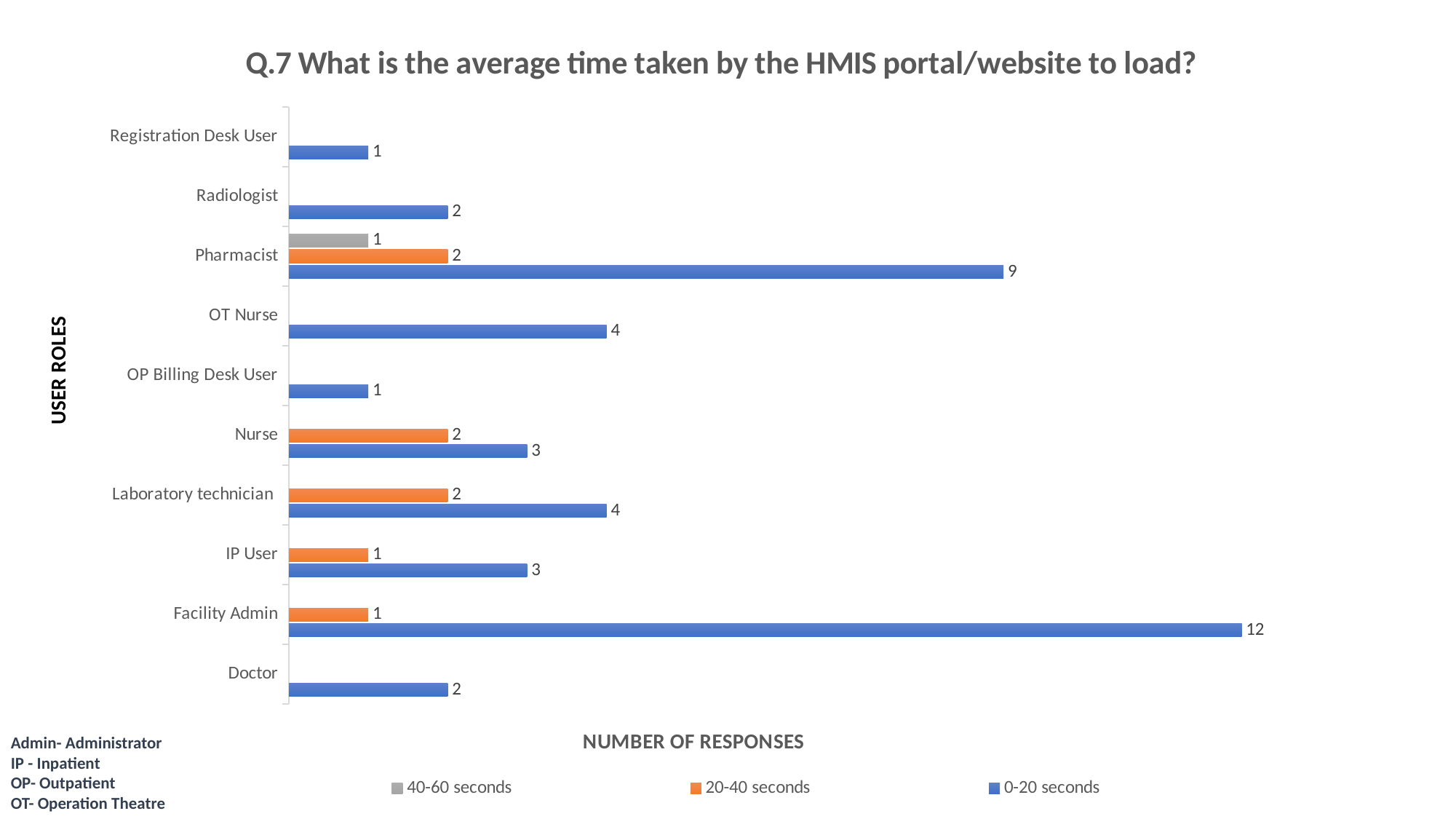
Which user role has the highest number of responses in the 0-20 seconds series? Facility Admin What is the total number of responses across all series for Pharmacist? 12 What is the difference between the 0-20 seconds responses for Facility Admin and Pharmacist? 3 What is the number of responses for Pharmacist in the 40-60 seconds series? 1 What is the number of responses for Nurse in the 20-40 seconds series? 2 What is the number of responses for Facility Admin in the 0-20 seconds series? 12 Which is larger: the 0-20 seconds value for OT Nurse or for Radiologist? OT Nurse What kind of chart is shown on the slide? bar chart What is the title of the chart? Q.7 What is the average time taken by the HMIS portal/website to load? How many series does the legend list? 3 Which user role is the only one with a bar in the 40-60 seconds series? Pharmacist How many user roles are shown on the y axis? 10